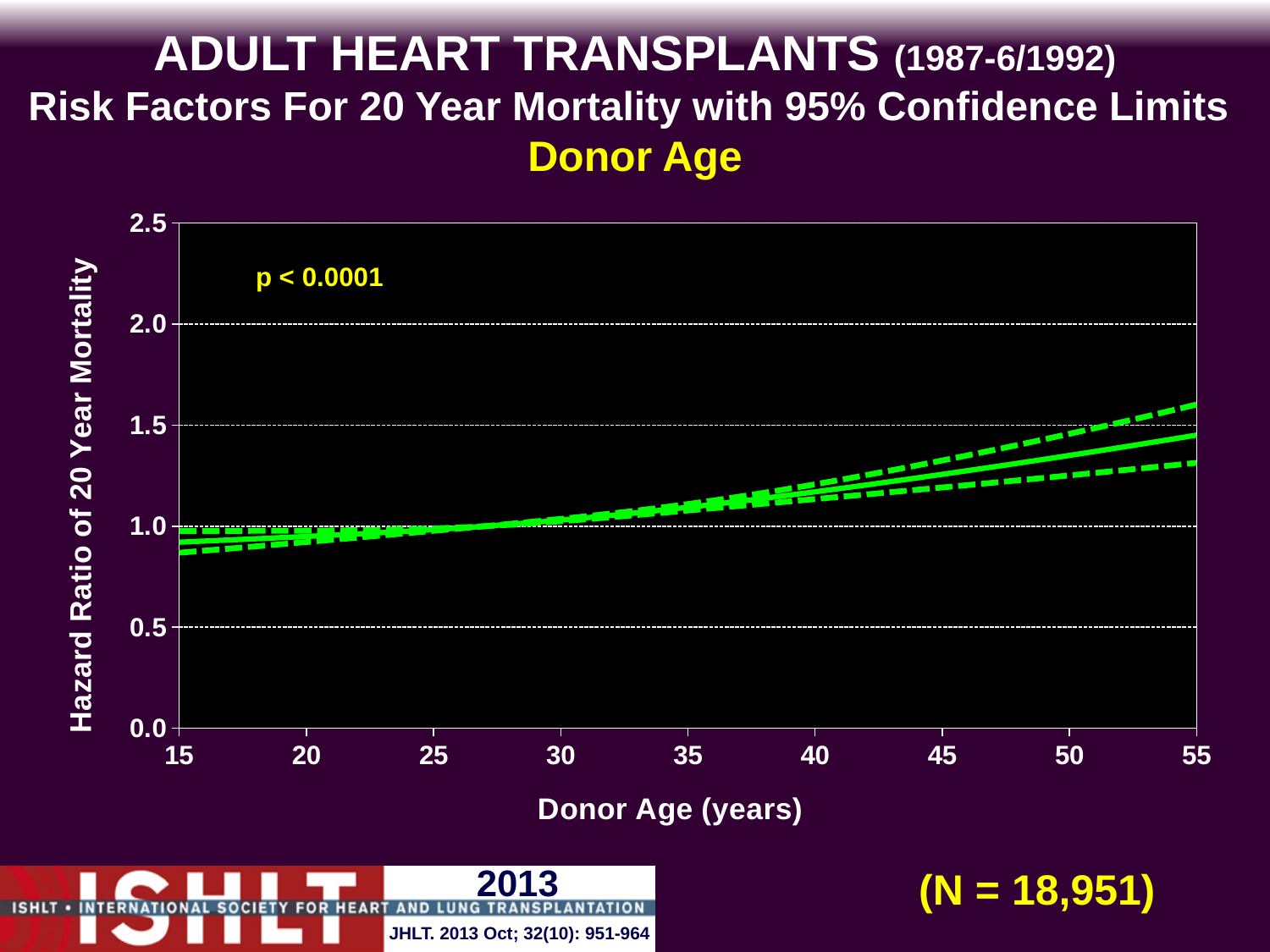
What p-value is printed on the chart? p < 0.0001 Does the hazard ratio of 20 year mortality rise or fall as donor age increases from 15 to 55 years? rise Is the lower 95% confidence limit at a donor age of 55 years greater or less than 1.5? less What kind of chart is shown on the slide? line chart Is the upper 95% confidence limit at a donor age of 55 years greater or less than 1.5? greater How many tick labels are shown on the x axis (Donor Age)? 9 Is the hazard ratio (solid line) at a donor age of 55 years greater or less than 1.0? greater Which has the higher hazard ratio on the solid line: a donor age of 20 years or a donor age of 50 years? 50 years What is the highest value shown on the y axis? 2.5 What is the label of the y axis? Hazard Ratio of 20 Year Mortality